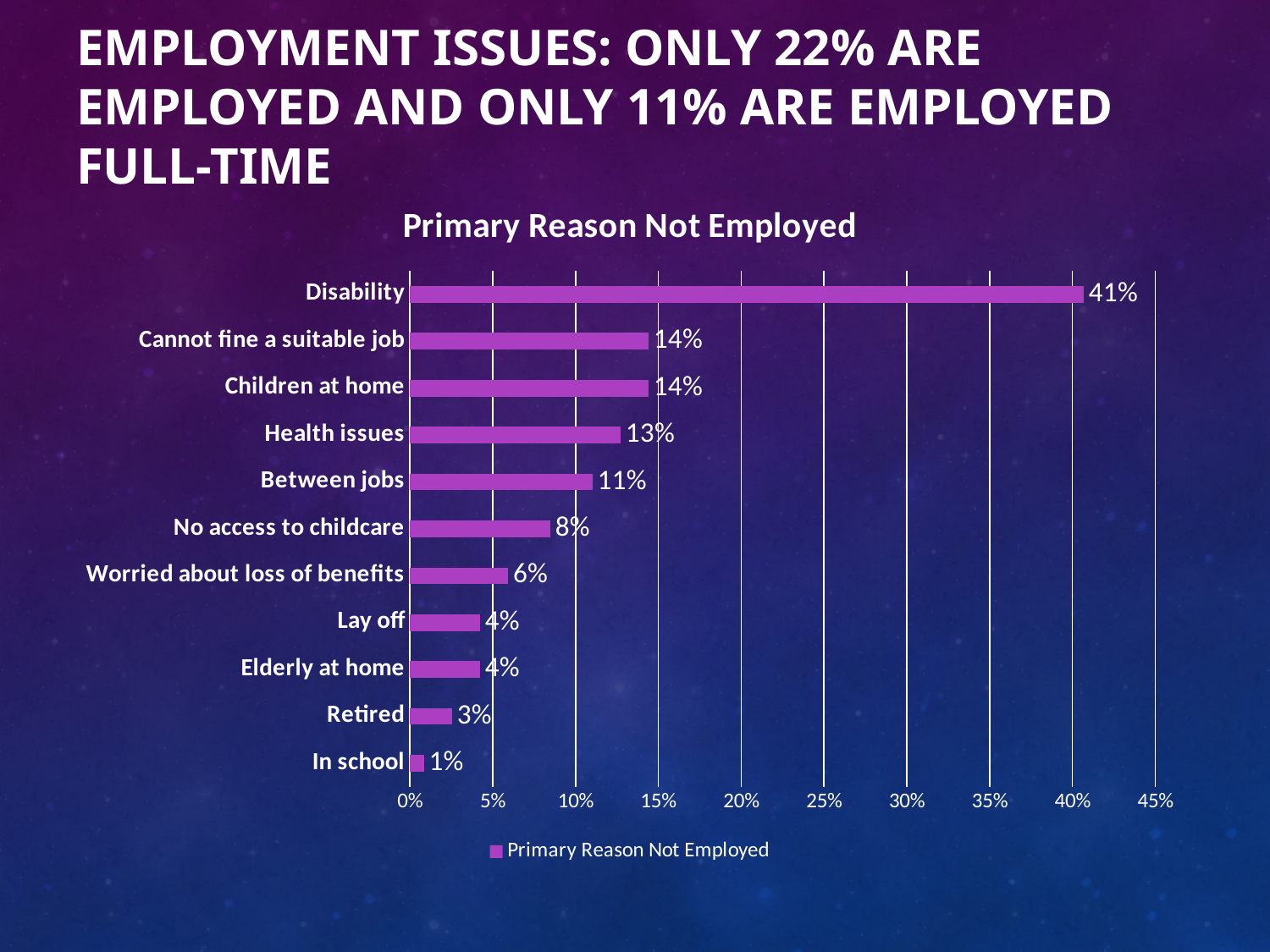
What is the value for Retired? 3% How many categories are shown in the chart? 11 Is the value for Disability greater or less than 40%? greater Which category has the highest value? Disability What is the value for No access to childcare? 8% Which is larger, the value for Health issues or the value for Worried about loss of benefits? Health issues What is the difference between the values for Disability and Between jobs? 30% What is the value for Disability? 41% Which category has the lowest value? In school What is the value for Health issues? 13% What kind of chart is shown on the slide? bar chart What is the title of the chart? Primary Reason Not Employed